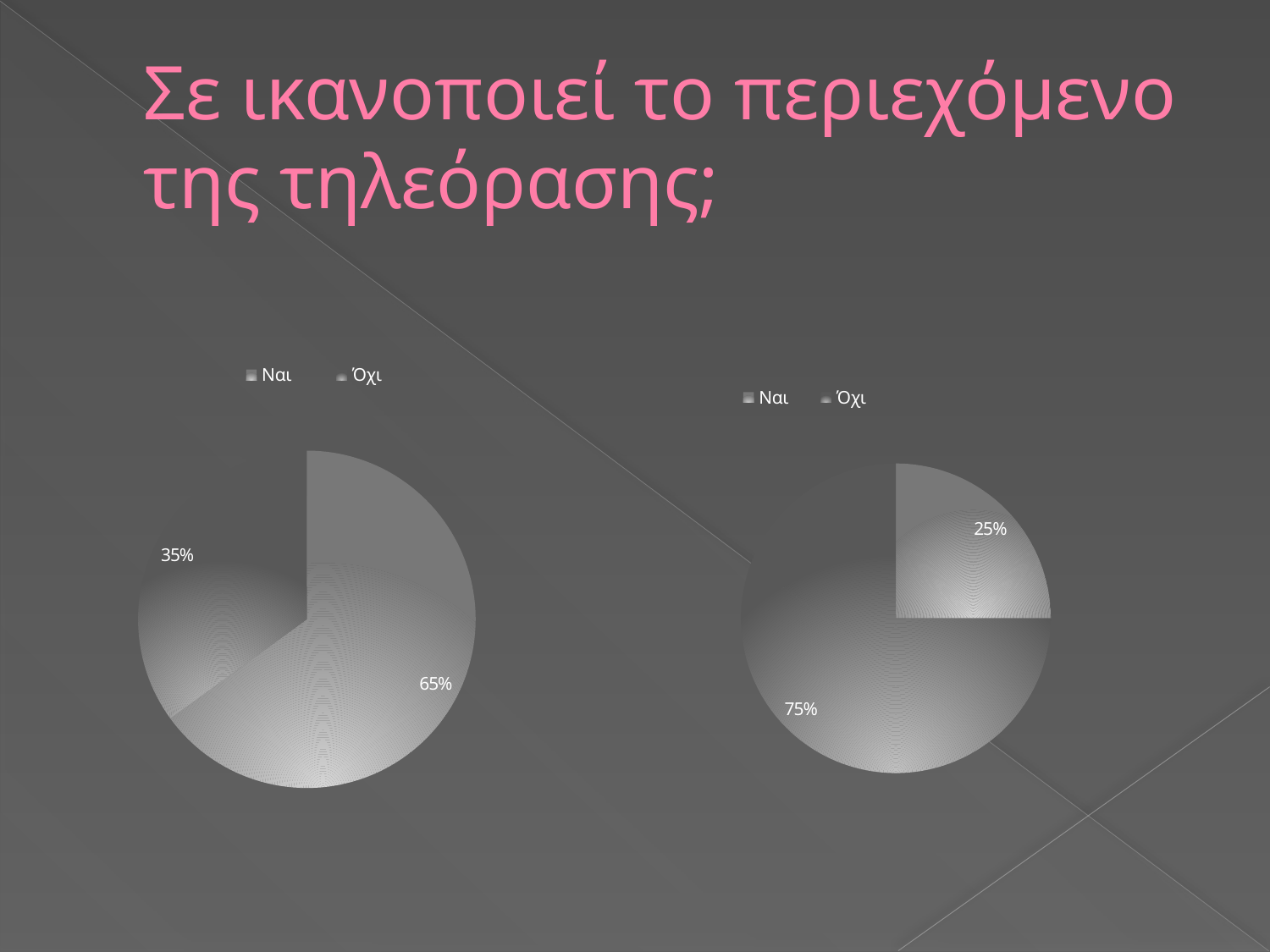
What are the two legend entries shown above the left pie chart? Ναι and Όχι In the left pie chart, what is the difference in percentage points between the two slices? 30 In the left pie chart, what percentage does the smallest slice show? 35% How many slices does the left pie chart have? 2 What kind of chart is the chart on the left of the slide? pie chart In the right pie chart, what is the difference in percentage points between the two slices? 50 What kind of chart is the chart on the right of the slide? pie chart In the right pie chart, what percentage does the smallest slice show? 25% Which is larger: the largest slice of the left pie chart or the largest slice of the right pie chart? the largest slice of the right pie chart In the left pie chart, what percentage does the largest slice show? 65% In the right pie chart, what percentage does the largest slice show? 75% How many entries does the legend of the right pie chart list? 2